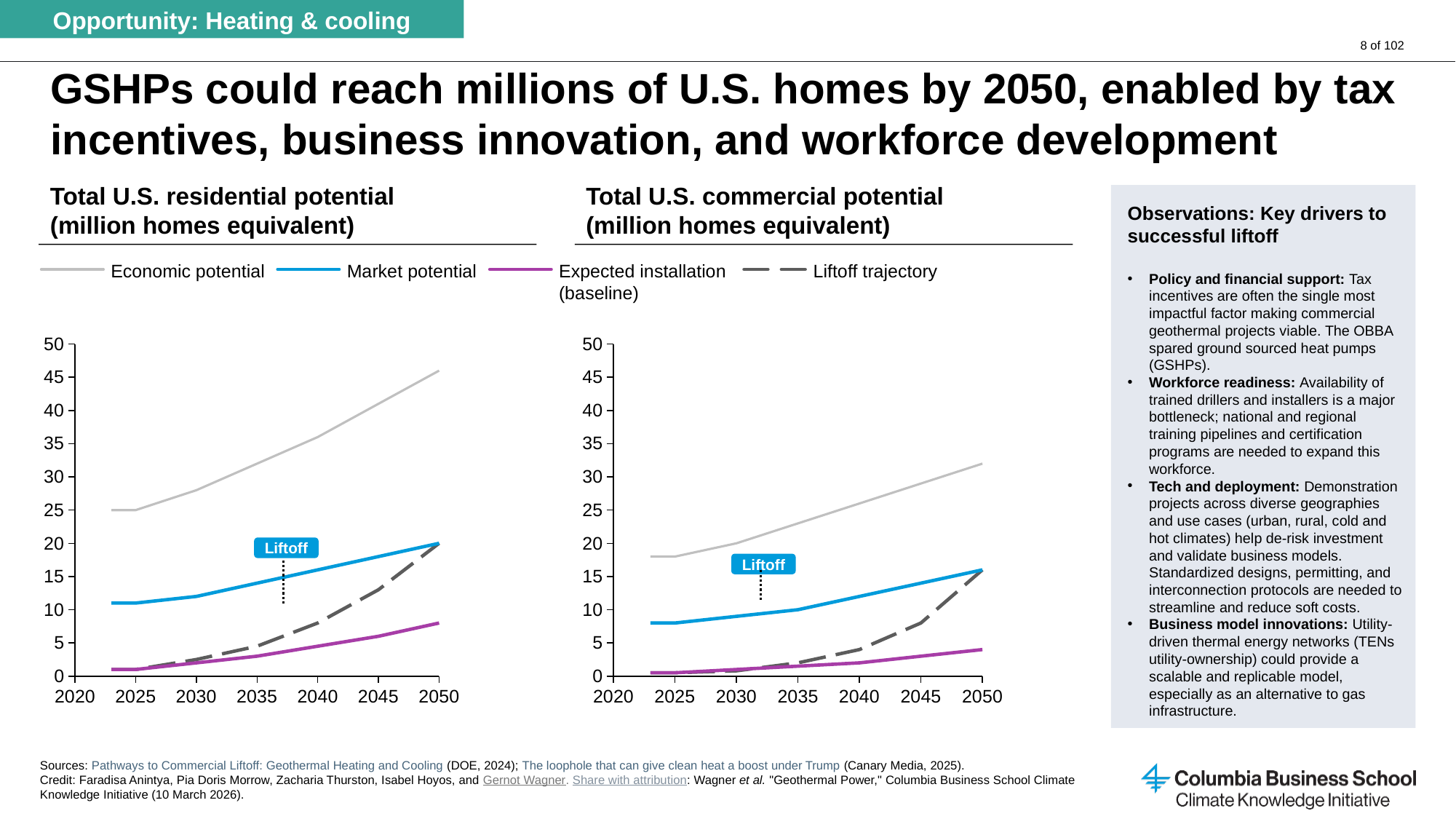
What is the first year shown on the x axis of the 'Total U.S. residential potential' chart? 2020 In the 'Total U.S. residential potential' chart, is the Economic potential value in 2050 greater or less than 40? greater In the 'Total U.S. residential potential' chart, is the Expected installation (baseline) value in 2050 greater or less than 10? less In the 'Total U.S. residential potential' chart, which series has the highest value in 2050? Economic potential In the 'Total U.S. commercial potential' chart, which is larger in 2050: Market potential or Expected installation (baseline)? Market potential In the 'Total U.S. residential potential' chart, does the Economic potential line rise or fall from 2025 to 2050? rise In the 'Total U.S. commercial potential' chart, is the Market potential value in 2025 greater or less than 10? less What kind of chart is the 'Total U.S. residential potential' chart? line chart How many series does the legend list for the charts? 4 What is the highest value shown on the y axis of the 'Total U.S. commercial potential' chart? 50 In the 'Total U.S. residential potential' chart, which series has the lowest value in 2050? Expected installation (baseline)